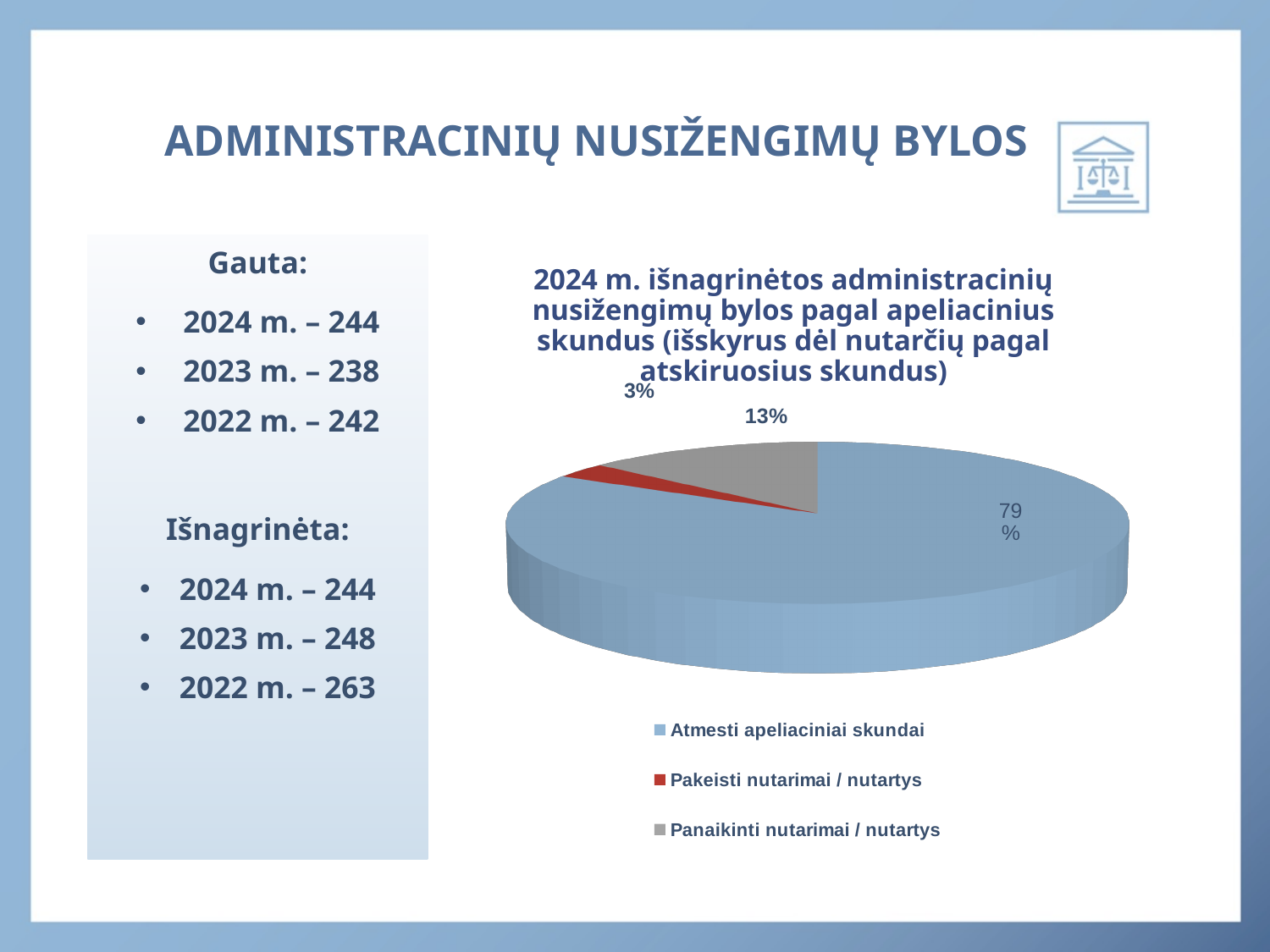
What share of the pie is labelled for "Atmesti apeliaciniai skundai"? 79% What share of the pie is labelled for "Panaikinti nutarimai / nutartys"? 13% What is the difference in percentage points between the "Atmesti apeliaciniai skundai" slice and the "Panaikinti nutarimai / nutartys" slice? 66 percentage points Which year does the pie chart's title say the data is for? 2024 Which category has the largest slice of the pie? Atmesti apeliaciniai skundai How many entries does the legend list? 3 How many categories does the pie chart show? 3 Which category has the smallest slice of the pie? Pakeisti nutarimai / nutartys Which slice is larger: "Panaikinti nutarimai / nutartys" or "Pakeisti nutarimai / nutartys"? Panaikinti nutarimai / nutartys What share of the pie is labelled for "Pakeisti nutarimai / nutartys"? 3% What colour is the slice for "Pakeisti nutarimai / nutartys"? red What type of chart is shown on the slide? pie chart